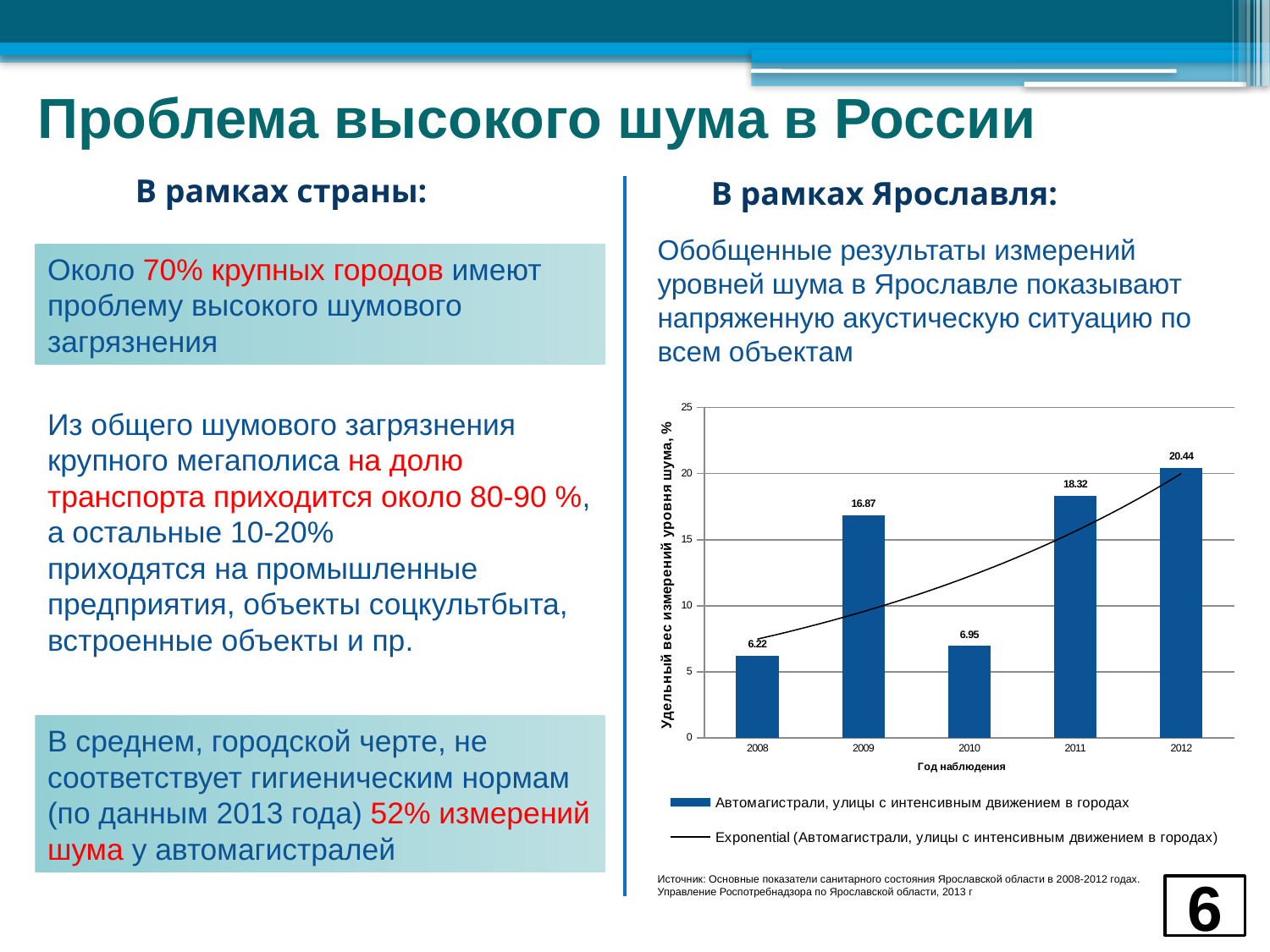
What is the difference between the values for 2012 and 2011? 2.12 Is the value for 2010 greater or less than 10? less What is the value for 2011? 18.32 Which year has the highest value? 2012 How many years are shown on the x axis? 5 What kind of chart is shown on the slide? bar chart What is the difference between the values for 2009 and 2010? 9.92 What is the value for 2012? 20.44 What is the label of the x axis? Год наблюдения Which year has the lowest value? 2008 Which is larger, the value for 2009 or the value for 2010? 2009 What is the value for 2008? 6.22